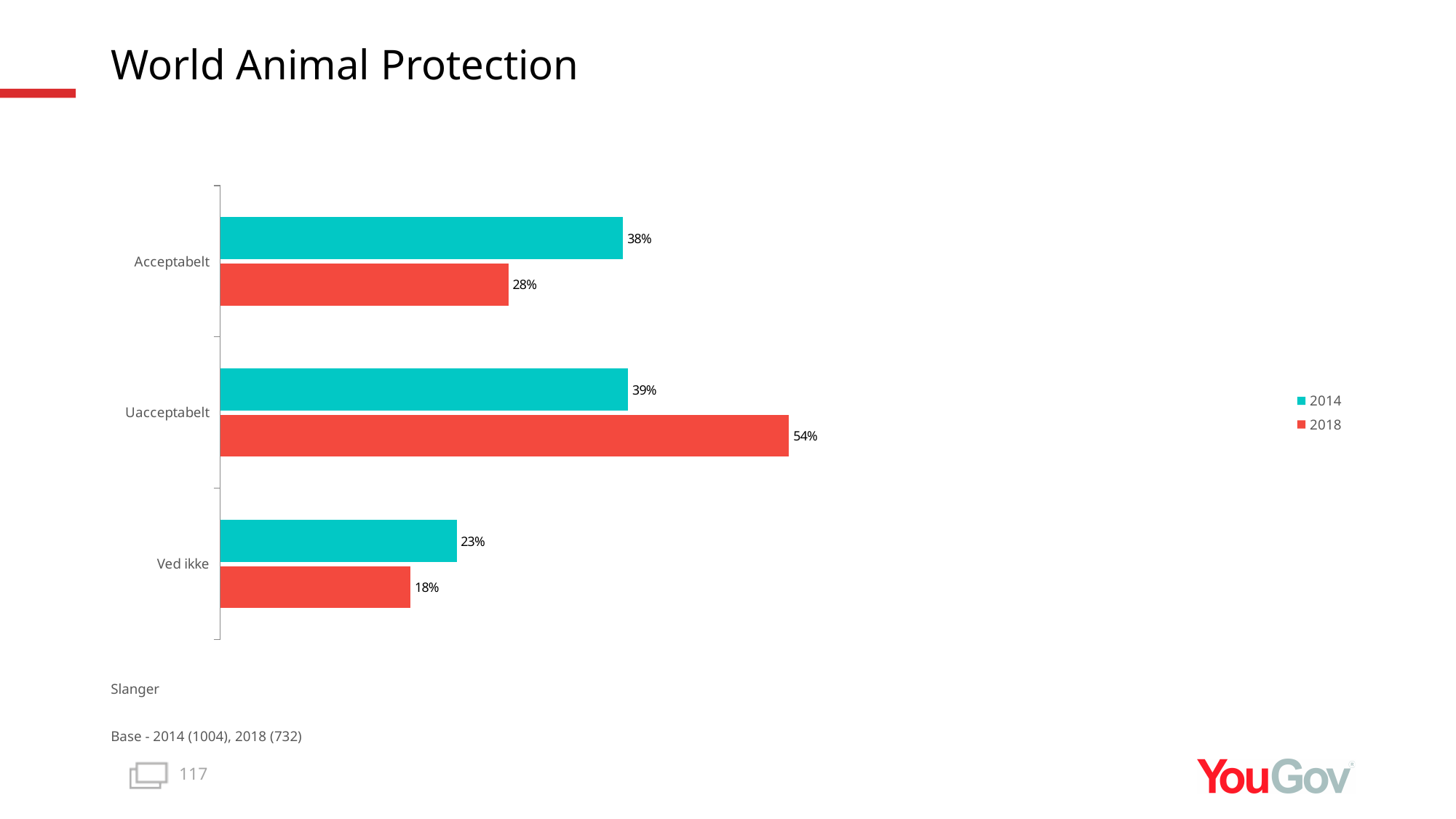
Which category has the highest 2018 value? Uacceptabelt What is the 2018 value for Ved ikke? 18% What is the 2014 value for Acceptabelt? 38% What kind of chart is shown on the slide? Bar chart What is the 2018 value for Uacceptabelt? 54% What is the 2014 value for Ved ikke? 23% Which category has the lowest 2014 value? Ved ikke Which is larger for Acceptabelt, the 2014 value or the 2018 value? 2014 How many categories are shown on the chart? 3 What is the difference between the 2018 and 2014 values for Uacceptabelt? 15% How many series does the legend list? 2 What is the difference between the 2014 and 2018 values for Acceptabelt? 10%